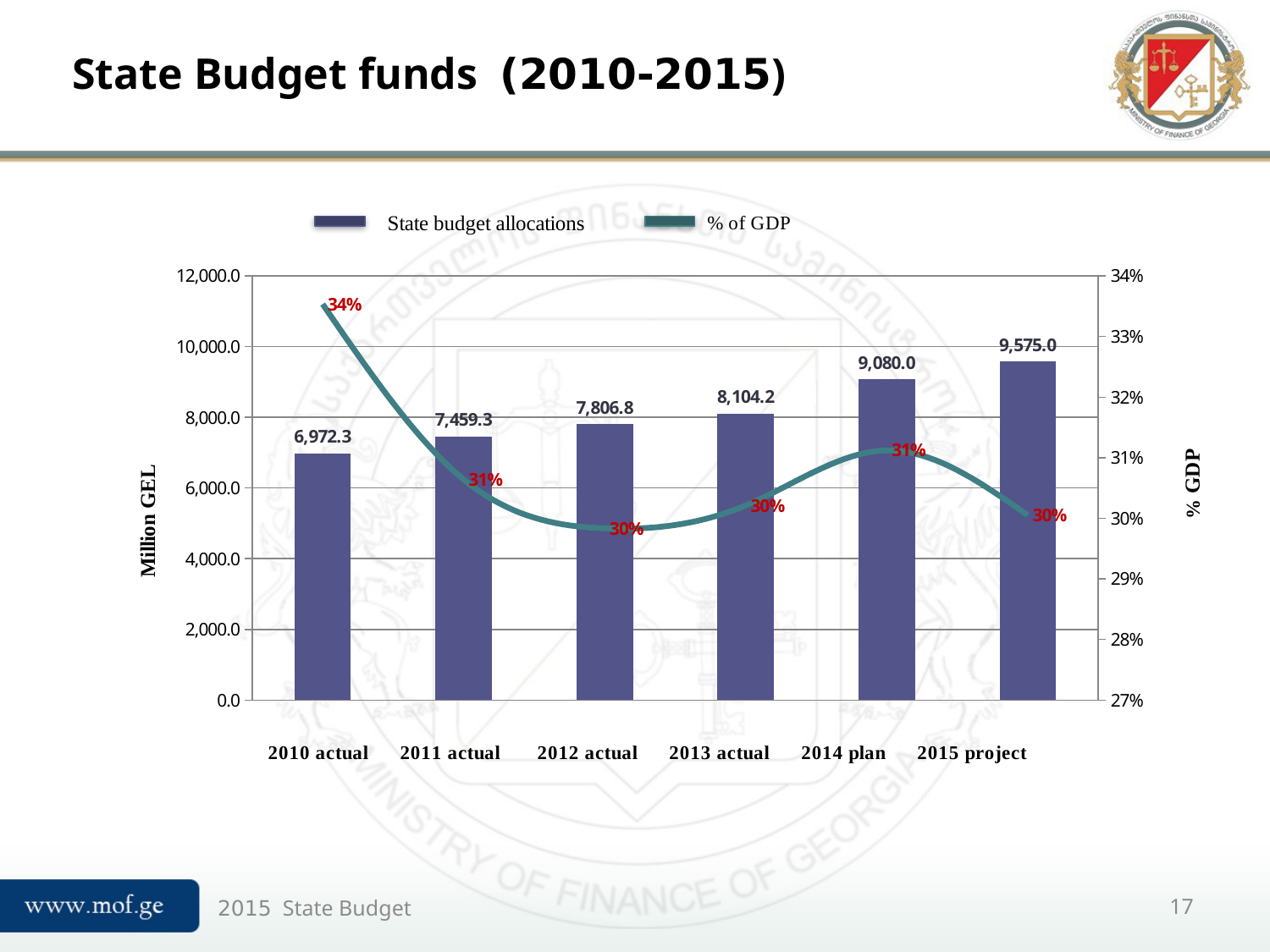
What is the label of the left vertical axis? Million GEL What is the State budget allocations value for 2010 actual? 6,972.3 What is the State budget allocations value for 2015 project? 9,575.0 How many series does the legend list? 2 What is the % of GDP value for 2010 actual? 34% What is the difference in State budget allocations between 2014 plan and 2013 actual? 975.8 Which category has the highest State budget allocations value? 2015 project Do the State budget allocations values rise or fall from 2010 actual to 2015 project? rise Which category has the lowest State budget allocations value? 2010 actual How many categories are shown on the x axis? 6 Which is larger, the State budget allocations value for 2012 actual or for 2011 actual? 2012 actual What is the % of GDP value for 2014 plan? 31%